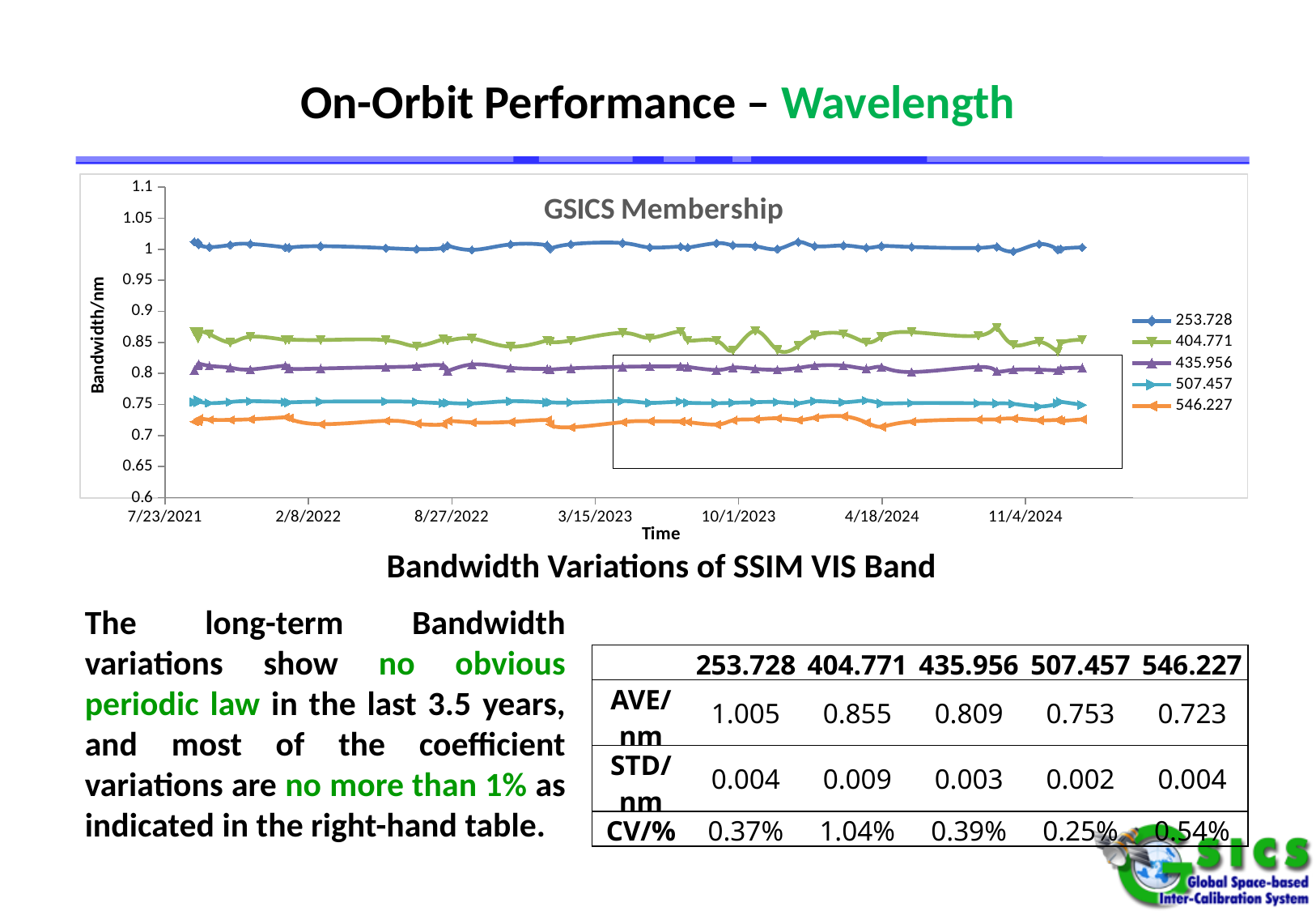
Which series has the lowest bandwidth values throughout the chart? 546.227 Are the values for the 435.956 series greater or less than 0.75? greater What is the label of the chart's vertical axis? Bandwidth/nm Which series is plotted higher on the chart, 404.771 or 435.956? 404.771 Are the values for the 404.771 series greater or less than 0.9? less Are the values for the 546.227 series greater or less than 0.75? less What kind of chart is shown on the slide? line chart Which series has the highest bandwidth values throughout the chart? 253.728 Which series is plotted higher on the chart, 507.457 or 546.227? 507.457 How many series does the chart's legend list? 5 What is the label of the chart's horizontal axis? Time